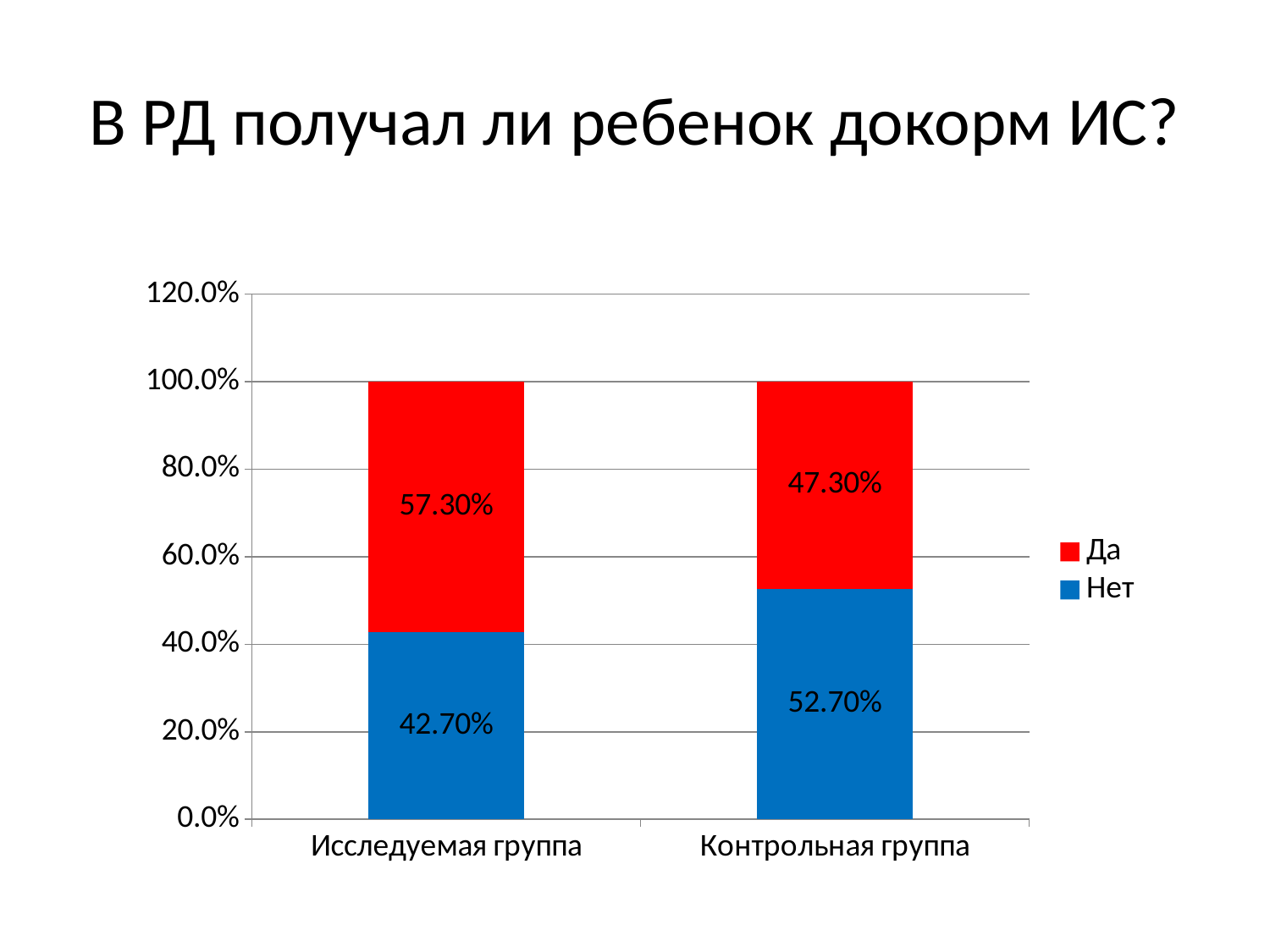
How many series does the legend list? 2 Which group has the lower "Нет" value? Исследуемая группа What kind of chart is shown on the slide? Stacked bar chart Which group has the higher "Да" value? Исследуемая группа What is the total of the stacked bar for Контрольная группа? 100.0% What is the value of "Нет" for Контрольная группа? 52.70% What is the difference between the "Да" values of Исследуемая группа and Контрольная группа? 10.00% How many categories are shown on the x axis? 2 What is the value of "Нет" for Исследуемая группа? 42.70% What is the value of "Да" for Исследуемая группа? 57.30% Is the "Нет" value larger for Исследуемая группа or Контрольная группа? Контрольная группа What is the value of "Да" for Контрольная группа? 47.30%